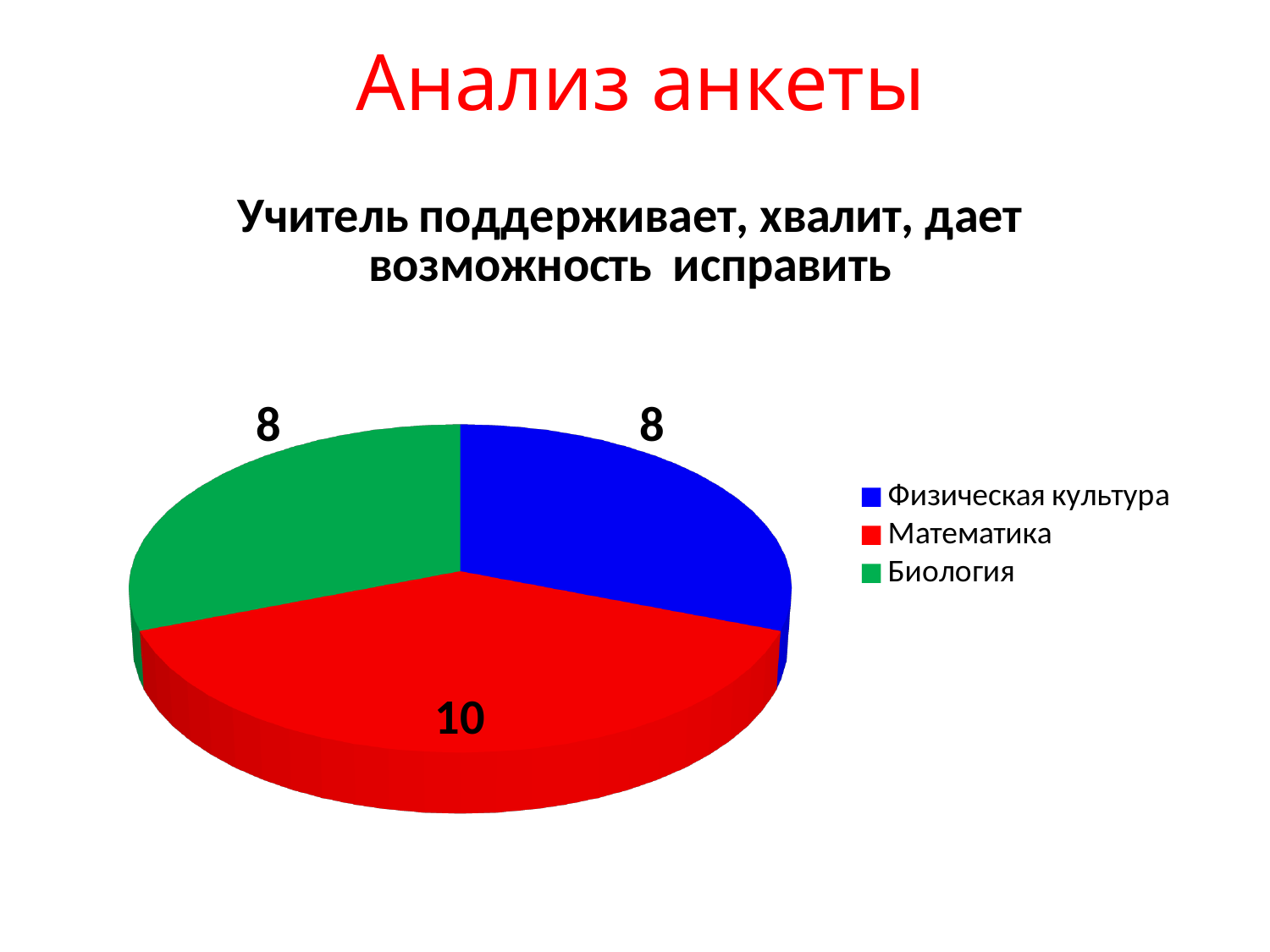
What colour is the Математика slice? Red How many slices does the pie chart have? 3 How many entries does the legend list? 3 What kind of chart is shown on the slide? Pie chart Which is larger, the value for Математика or the value for Физическая культура? Математика What is the difference between the values for Математика and Биология? 2 What is the value for Физическая культура? 8 What is the total of all slices in the pie chart? 26 Which two categories share the lowest value? Физическая культура and Биология Which category has the highest value? Математика What is the value for Математика? 10 What is the value for Биология? 8